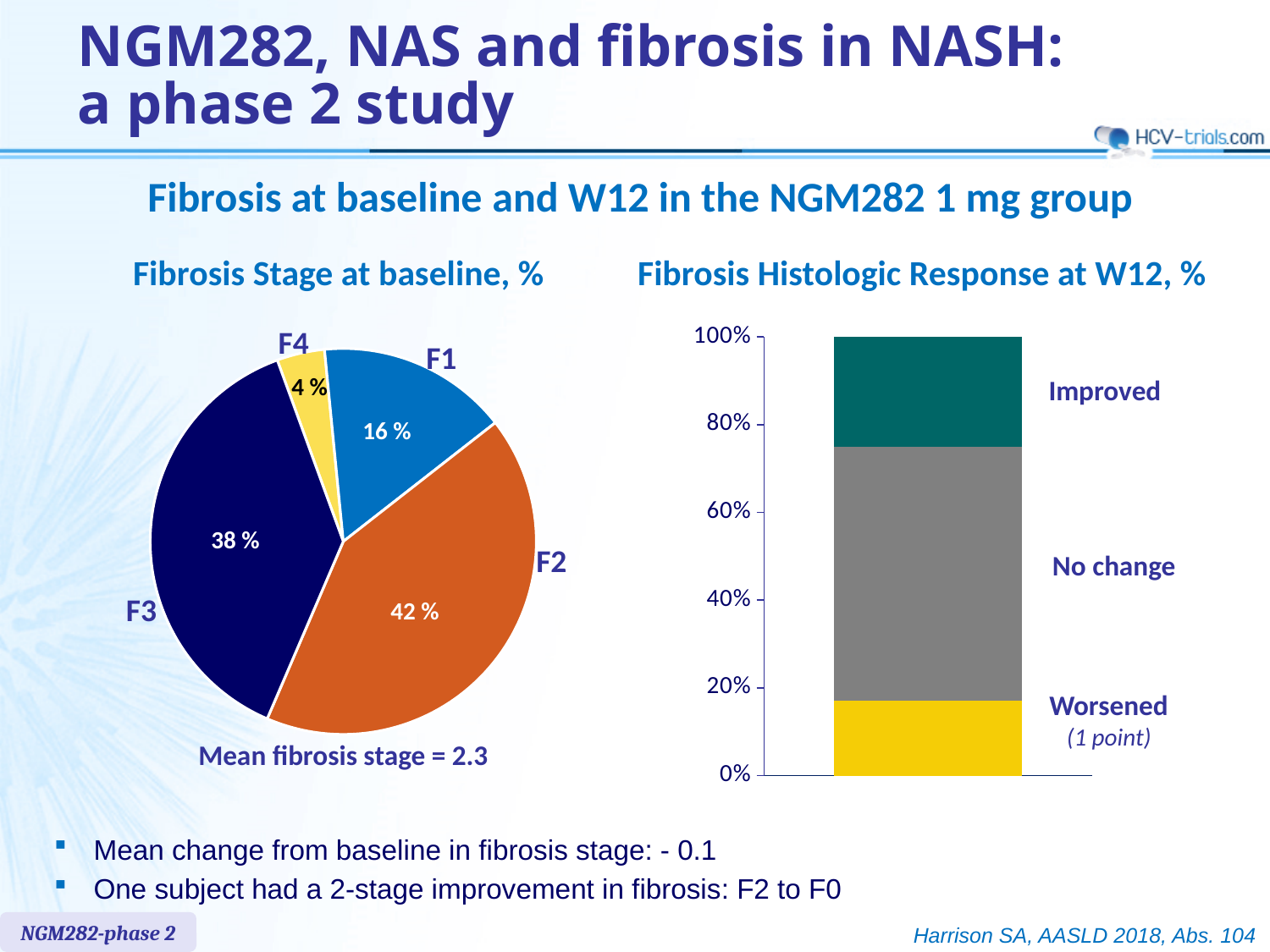
In the 'Fibrosis Stage at baseline, %' pie chart, what is the difference in percentage points between F3 and F1? 22 In the 'Fibrosis Stage at baseline, %' pie chart, what percentage of subjects were at stage F2? 42 % What type of chart is used for 'Fibrosis Histologic Response at W12, %'? Stacked bar chart In the 'Fibrosis Stage at baseline, %' pie chart, which fibrosis stage has the smallest share? F4 In the 'Fibrosis Histologic Response at W12, %' chart, is the 'No change' segment greater or less than 40%? greater How many fibrosis stages are shown in the 'Fibrosis Stage at baseline, %' pie chart? 4 In the 'Fibrosis Stage at baseline, %' pie chart, what percentage of subjects were at stage F4? 4 % What type of chart is used for 'Fibrosis Stage at baseline, %'? Pie chart What mean fibrosis stage is reported below the 'Fibrosis Stage at baseline, %' pie chart? 2.3 In the 'Fibrosis Histologic Response at W12, %' chart, is the 'Worsened' segment greater or less than 20%? less In the 'Fibrosis Stage at baseline, %' pie chart, which fibrosis stage has the largest share? F2 In the 'Fibrosis Stage at baseline, %' pie chart, which is larger, the share for F1 or the share for F3? F3